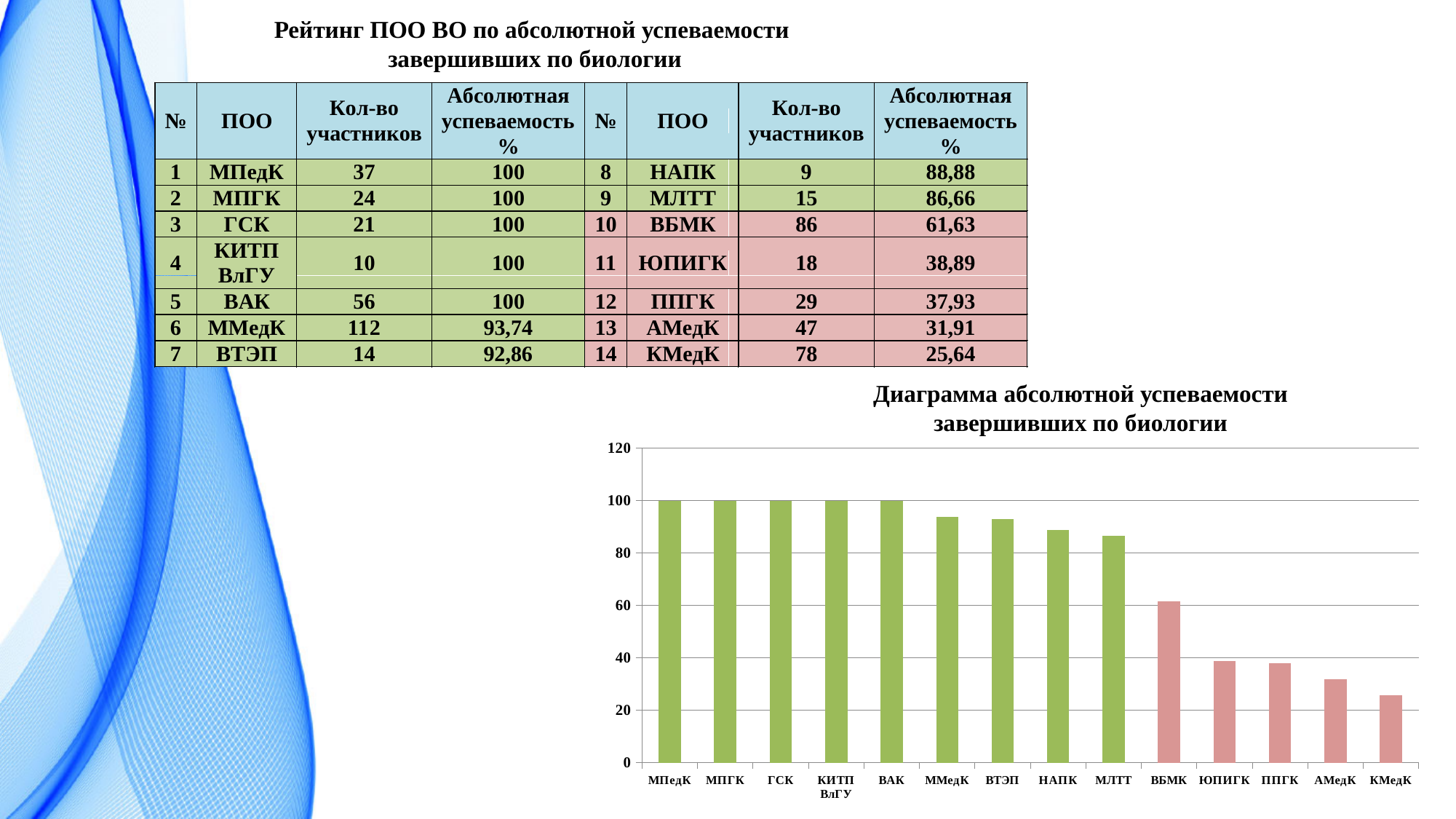
What kind of chart is shown on the slide? bar chart Do the bar values rise or fall from left to right along the x axis of the chart? fall What is the value of the bar for МПедК in the chart? 100 Which institution has the lowest bar in the chart? КМедК What is the title of the chart? Диаграмма абсолютной успеваемости завершивших по биологии How many institutions (categories) are plotted on the x axis of the chart? 14 Is the value for КМедК in the chart greater or less than 40? less In the chart, which bar is taller: МЛТТ or ВБМК? МЛТТ What is the value of the bar for ВАК in the chart? 100 Is the value for ММедК in the chart greater or less than 80? greater Is the value for ЮПИГК in the chart greater or less than 60? less